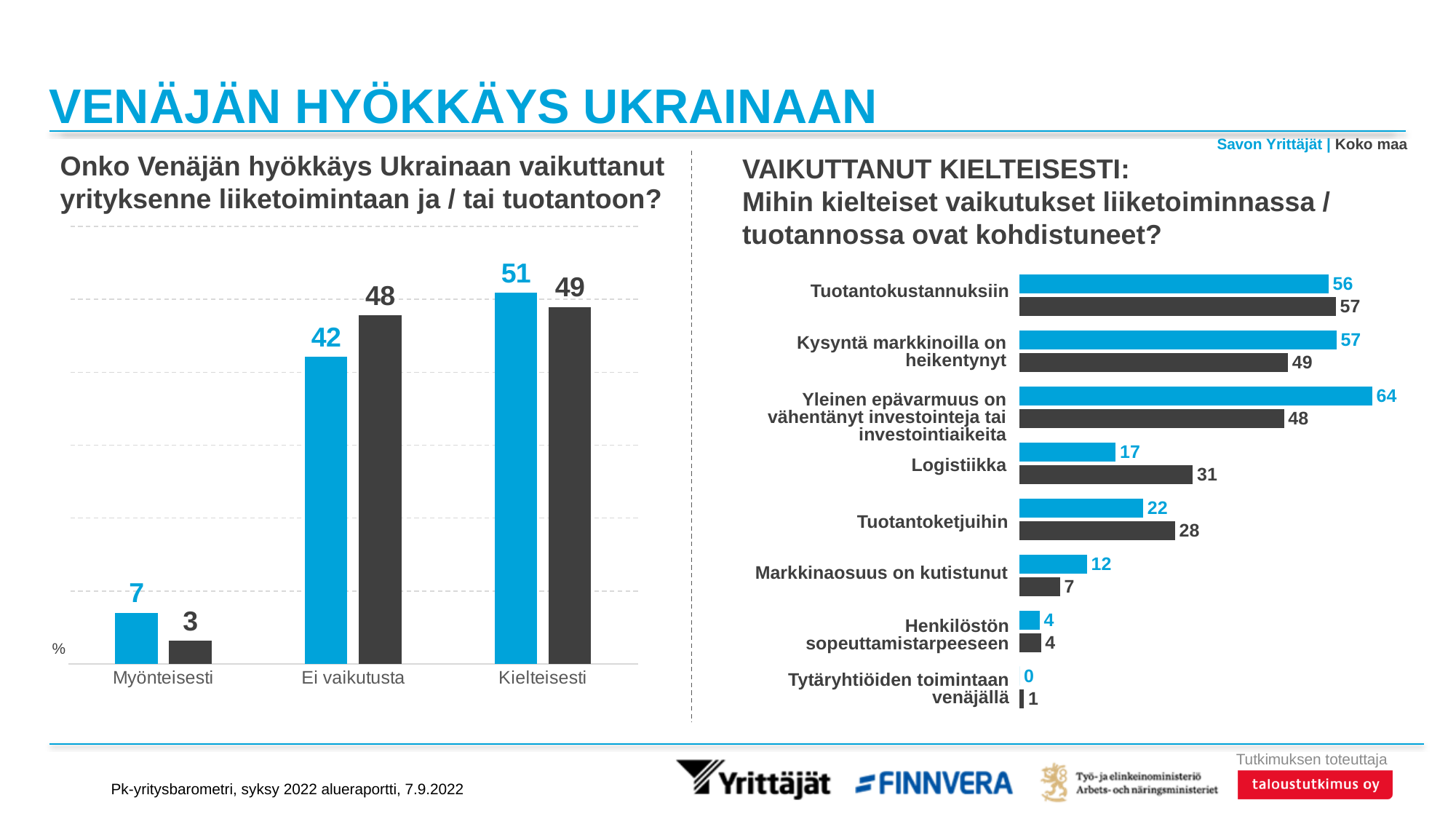
In the left chart, how many categories are shown on the x axis? 3 In the right chart, which is larger for Tuotantoketjuihin: the Savon Yrittäjät value or the Koko maa value? Koko maa In the right chart, which category has the highest Savon Yrittäjät value? Yleinen epävarmuus on vähentänyt investointeja tai investointiaikeita In the left chart, which category has the lowest Savon Yrittäjät value? Myönteisesti What kind of chart is the left chart? Bar chart In the right chart, what is the Koko maa value for Logistiikka? 31 In the left chart (Onko Venäjän hyökkäys Ukrainaan vaikuttanut...), what is the Savon Yrittäjät value for Kielteisesti? 51 In the right chart, what is the difference between the Savon Yrittäjät and Koko maa values for Kysyntä markkinoilla on heikentynyt? 8 In the right chart (Vaikuttanut kielteisesti), what is the Savon Yrittäjät value for Yleinen epävarmuus on vähentänyt investointeja tai investointiaikeita? 64 In the left chart, what is the difference between the Savon Yrittäjät and Koko maa values for Myönteisesti? 4 How many series does the legend list? 2 In the left chart, what is the Koko maa value for Ei vaikutusta? 48